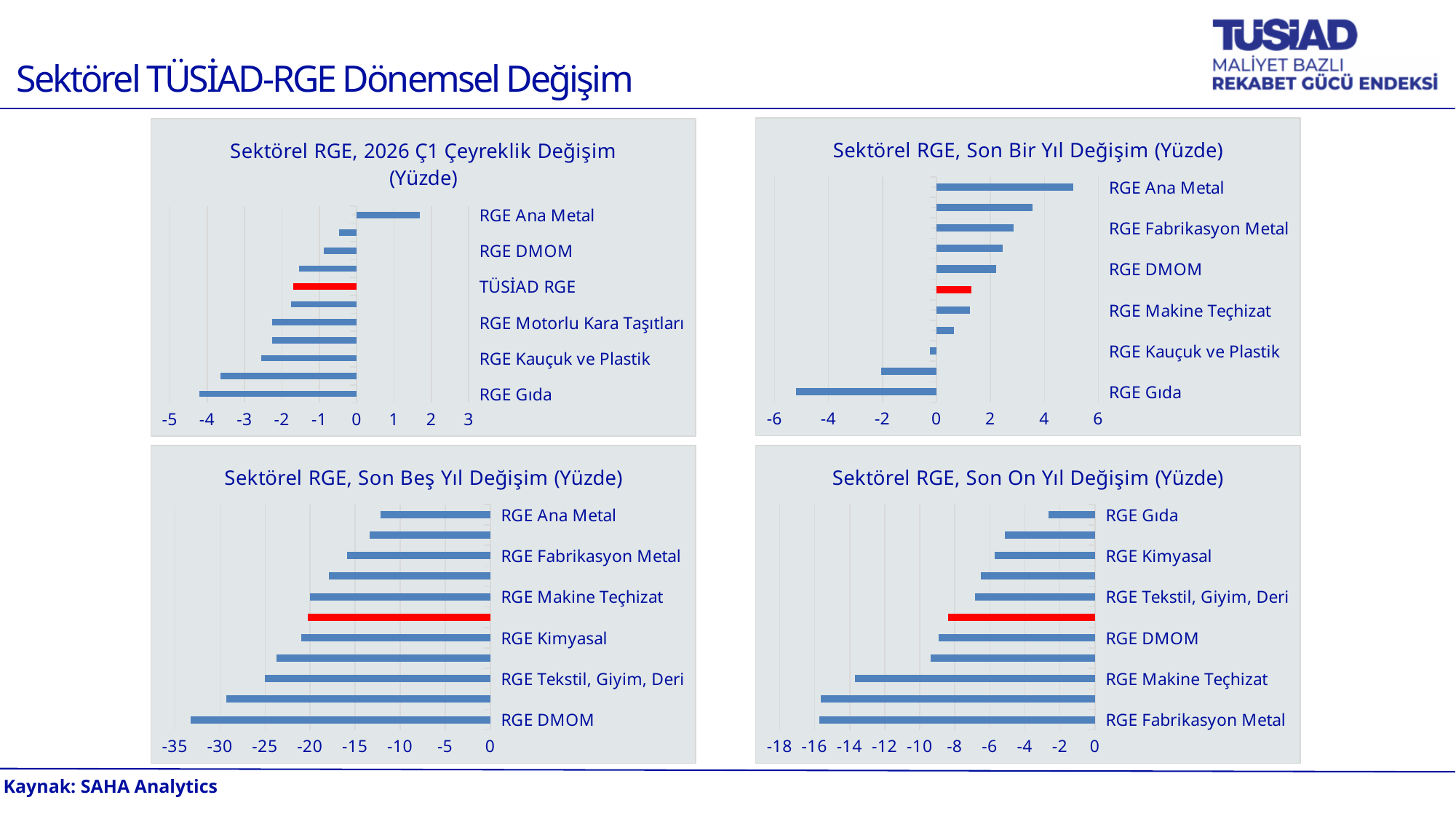
In the chart 'Sektörel RGE, Son Bir Yıl Değişim (Yüzde)', which is larger, the value for RGE Fabrikasyon Metal or the value for RGE Makine Teçhizat? RGE Fabrikasyon Metal In the chart 'Sektörel RGE, Son Beş Yıl Değişim (Yüzde)', which labelled category has the lowest value? RGE DMOM How many bars are plotted in the chart 'Sektörel RGE, Son On Yıl Değişim (Yüzde)'? 11 In the chart 'Sektörel RGE, 2026 Ç1 Çeyreklik Değişim (Yüzde)', is the value for RGE Gıda greater or less than -4? less In the chart 'Sektörel RGE, Son On Yıl Değişim (Yüzde)', is the value for RGE Fabrikasyon Metal greater or less than -14? less In the chart 'Sektörel RGE, Son Bir Yıl Değişim (Yüzde)', which labelled category has the highest value? RGE Ana Metal In the chart 'Sektörel RGE, Son Beş Yıl Değişim (Yüzde)', is the value for RGE DMOM greater or less than -30? less In the chart 'Sektörel RGE, Son Beş Yıl Değişim (Yüzde)', which is larger, the value for RGE Ana Metal or the value for RGE Tekstil, Giyim, Deri? RGE Ana Metal What kind of chart is 'Sektörel RGE, 2026 Ç1 Çeyreklik Değişim (Yüzde)'? Bar chart In the chart 'Sektörel RGE, 2026 Ç1 Çeyreklik Değişim (Yüzde)', which labelled category has the lowest value? RGE Gıda